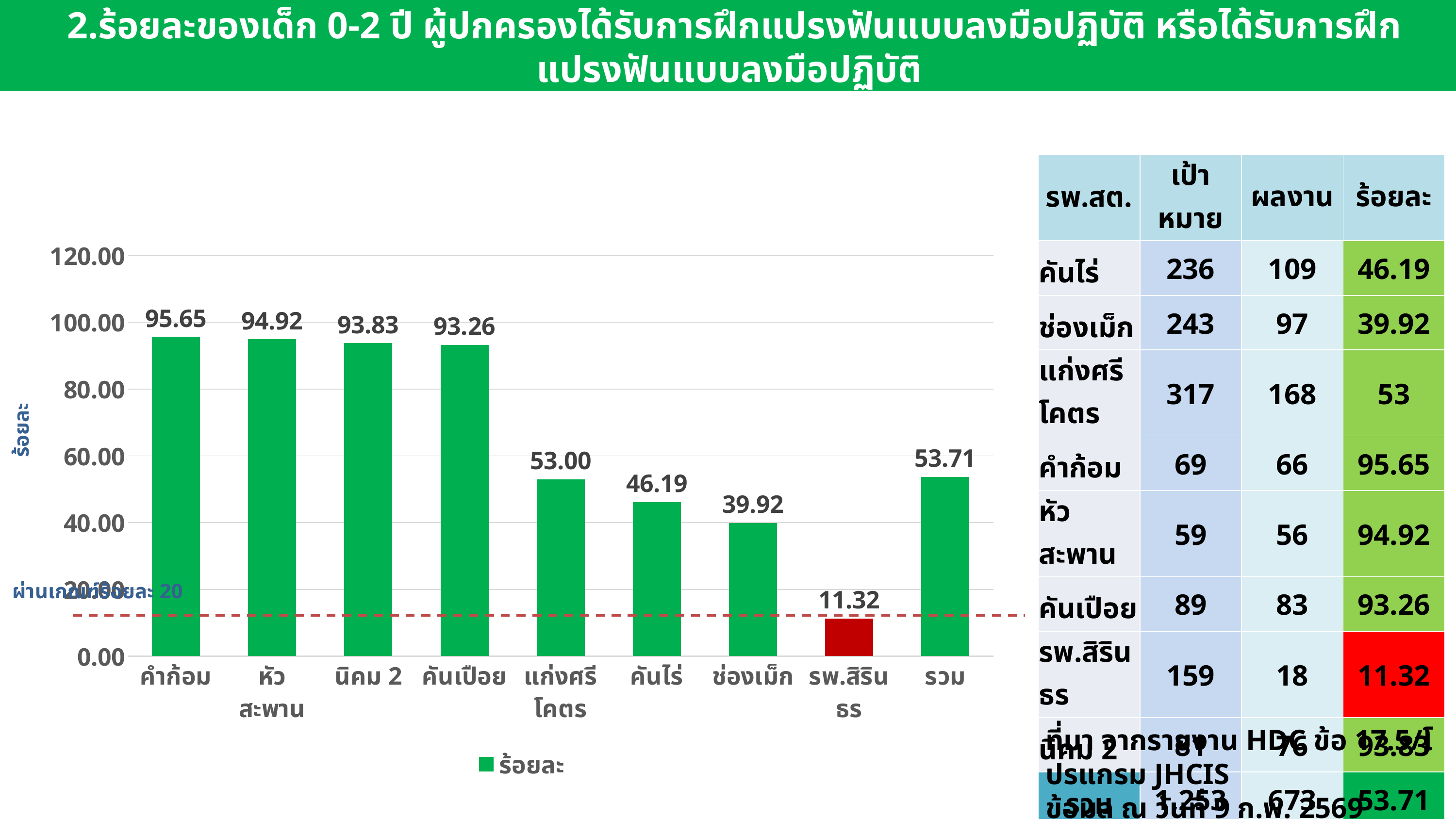
Which category has the highest value? คำก้อม How many series does the legend list? 1 Is the value for คันเปือย greater or less than 80.00? greater What is the value for ช่องเม็ก? 39.92 Which category has the lowest value? รพ.สิรินธร What kind of chart is shown? bar chart What is the value for คำก้อม? 95.65 How many categories are shown on the x axis? 9 What is the difference between the values for คำก้อม and รพ.สิรินธร? 84.33 What is the value for รพ.สิรินธร? 11.32 Which is larger, the value for แก่งศรีโคตร or the value for คันไร่? แก่งศรีโคตร What is the value for รวม? 53.71